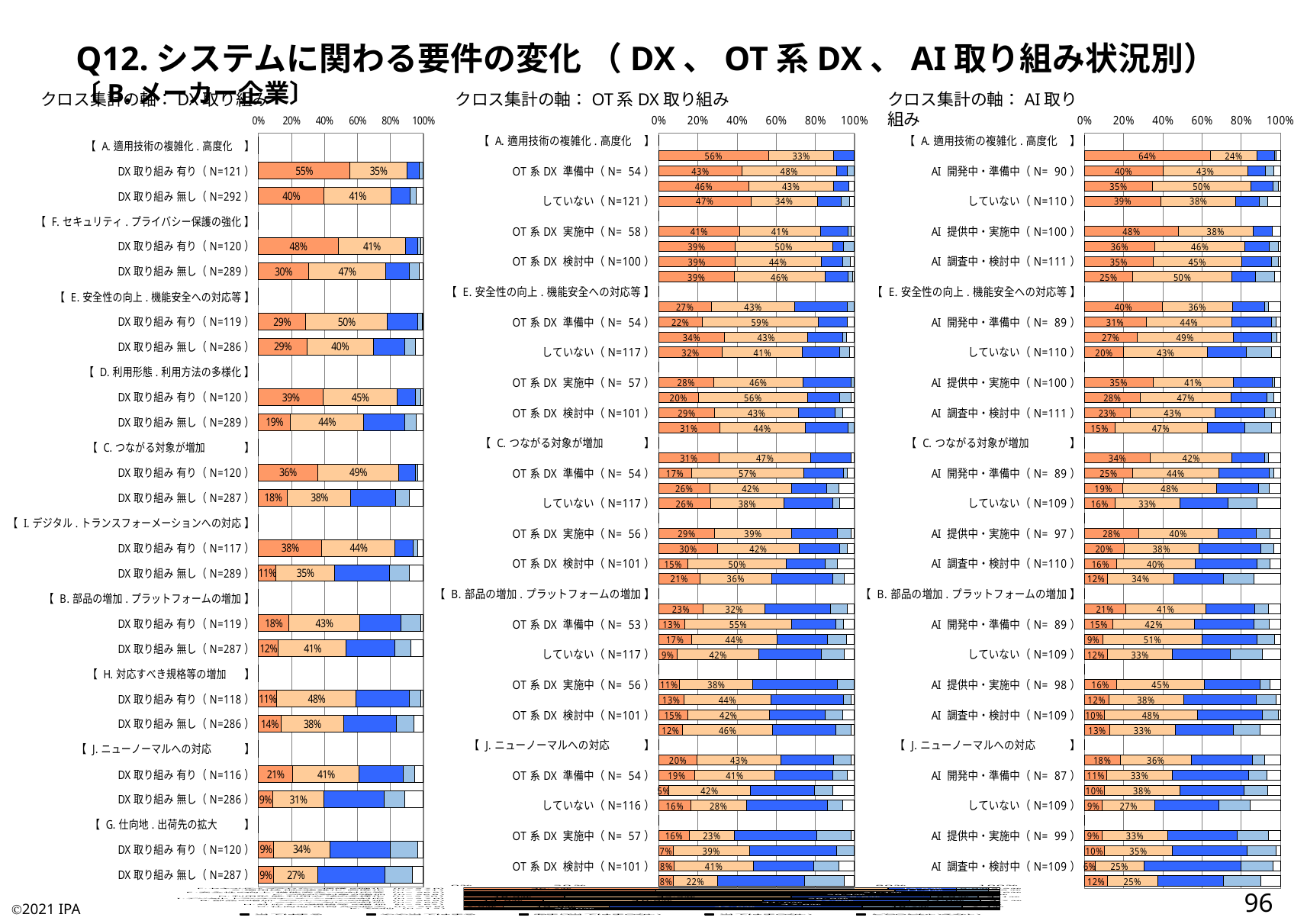
How many charts are shown on the slide? 3 In the left chart (クロス集計の軸：DX取り組み), what is the first (dark orange) value for DX取り組み有り (N=120) under G. 仕向地.出荷先の拡大? 9% In the left chart (クロス集計の軸：DX取り組み), among the DX取り組み有り rows, which category has the highest first (dark orange) value? A. 適用技術の複雑化.高度化 What kind of chart is used on this slide? Stacked horizontal bar chart In the left chart (クロス集計の軸：DX取り組み), under F. セキュリティ.プライバシー保護の強化, which row has the larger first (dark orange) segment: DX取り組み有り or DX取り組み無し? DX取り組み有り In the left chart (クロス集計の軸：DX取り組み), what is the first (dark orange) value for DX取り組み無し (N=292) under A. 適用技術の複雑化.高度化? 40% In the left chart (クロス集計の軸：DX取り組み), under A. 適用技術の複雑化.高度化, how many percentage points higher is the first segment for DX取り組み有り (55%) than for DX取り組み無し (40%)? 15 percentage points In the middle chart (クロス集計の軸：OT系DX取り組み), what is the first (dark orange) value for OT系DX 準備中 (N=54) under A. 適用技術の複雑化.高度化? 43% In the right chart (クロス集計の軸：AI取り組み), what is the second (light orange) value for AI 開発中・準備中 (N=90) under A. 適用技術の複雑化.高度化? 43% In the left chart (クロス集計の軸：DX取り組み), what is the first (dark orange) value for DX取り組み有り (N=121) under A. 適用技術の複雑化.高度化? 55% In the left chart (クロス集計の軸：DX取り組み), what is the second (light orange) value for DX取り組み有り (N=119) under E. 安全性の向上.機能安全への対応等? 50%